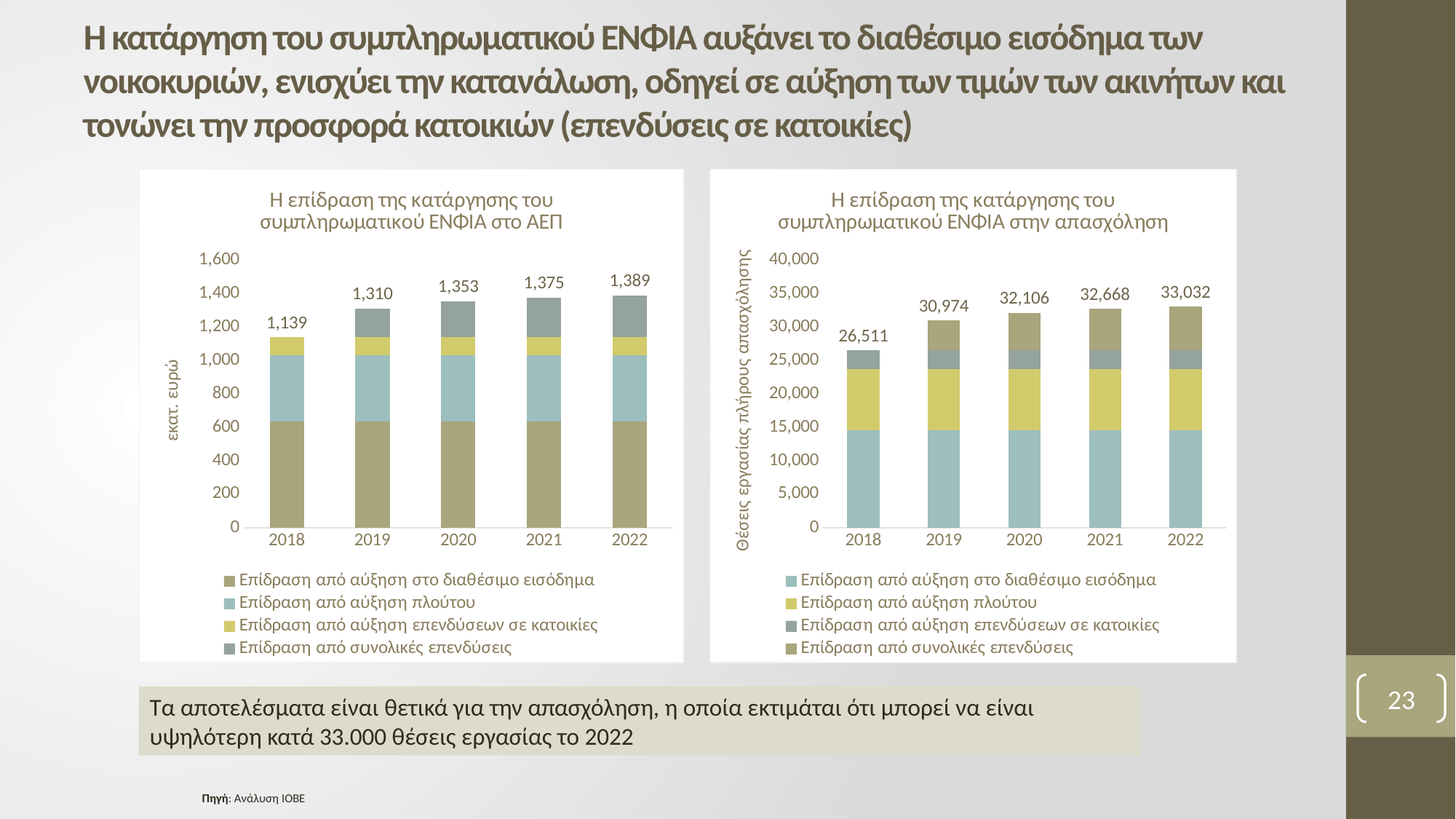
In the left chart (effect on GDP), is the total for 2019 greater or less than 1,200? greater In the right chart (effect on employment), which year has the lowest total? 2018 In the right chart (effect on employment), what is the difference between the 2020 total and the 2019 total? 1,132 How many years are shown on the x axis of the right chart (effect on employment)? 5 In the right chart (effect on employment), what is the total value labelled for 2022? 33,032 In the left chart (effect on GDP), what is the total value labelled for 2018? 1,139 How many series does the legend of the left chart (effect on GDP) list? 4 In the left chart (effect on GDP), which year has the highest total? 2022 What type of chart is the right chart (effect on employment)? Stacked bar chart In the left chart (effect on GDP), what is the difference between the 2022 total and the 2018 total? 250 In the right chart (effect on employment), what is the total value labelled for 2019? 30,974 In the left chart (effect on GDP), what is the total value labelled for 2022? 1,389